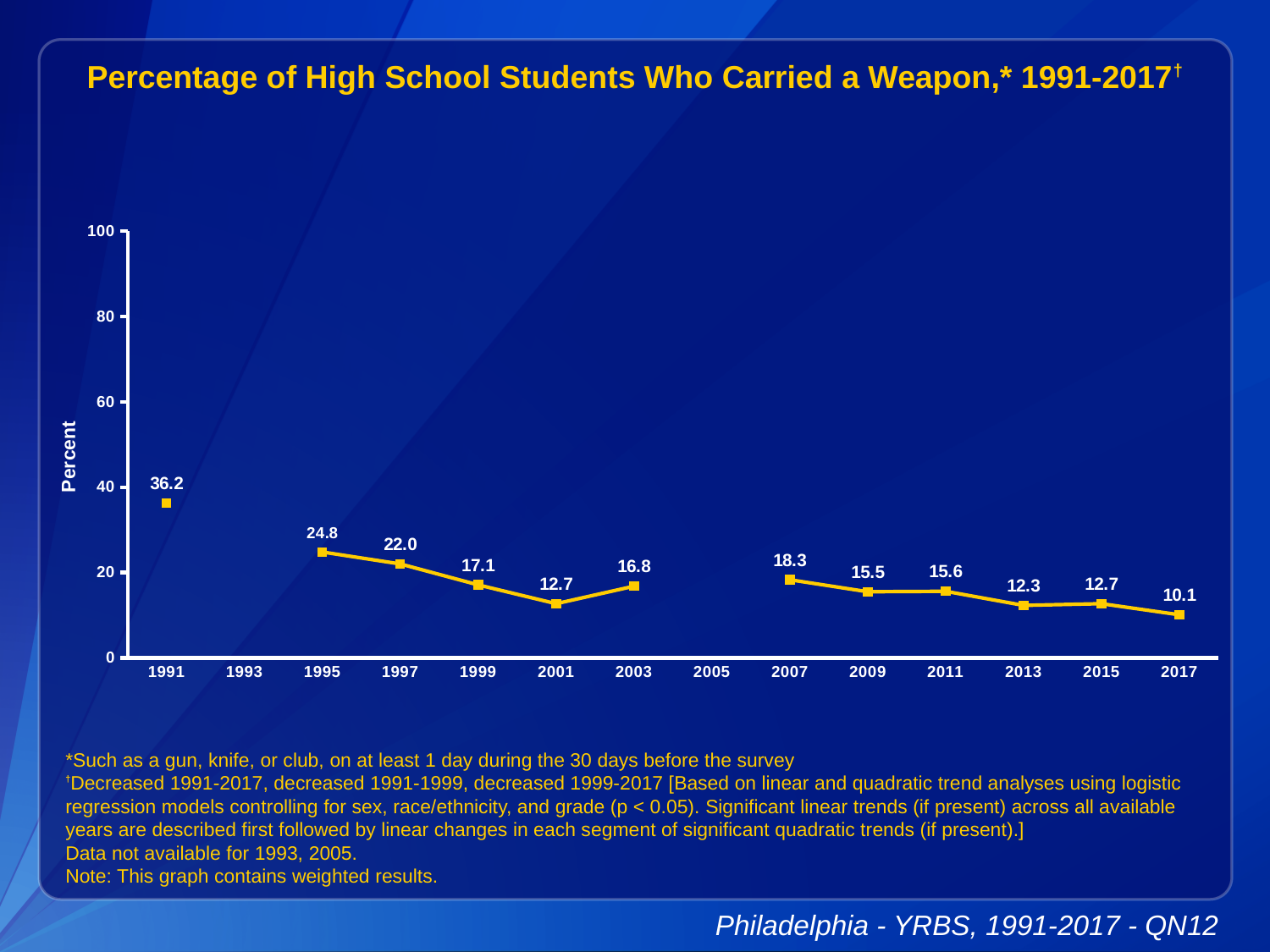
What is the value plotted for 2017? 10.1 Which year has the lowest percentage of students who carried a weapon? 2017 What kind of chart is shown on the slide? Line chart Which year has the highest percentage of students who carried a weapon? 1991 What is the label on the vertical axis? Percent How many years have a plotted data point on the chart? 12 Is the value for 1995 greater or less than 20? greater What percentage of high school students carried a weapon in 1991? 36.2 Overall, do the values rise or fall from 1991 to 2017? Fall What is the value plotted for 2007? 18.3 Which year has a higher value, 2003 or 2001? 2003 What is the difference between the 1991 value and the 2017 value? 26.1